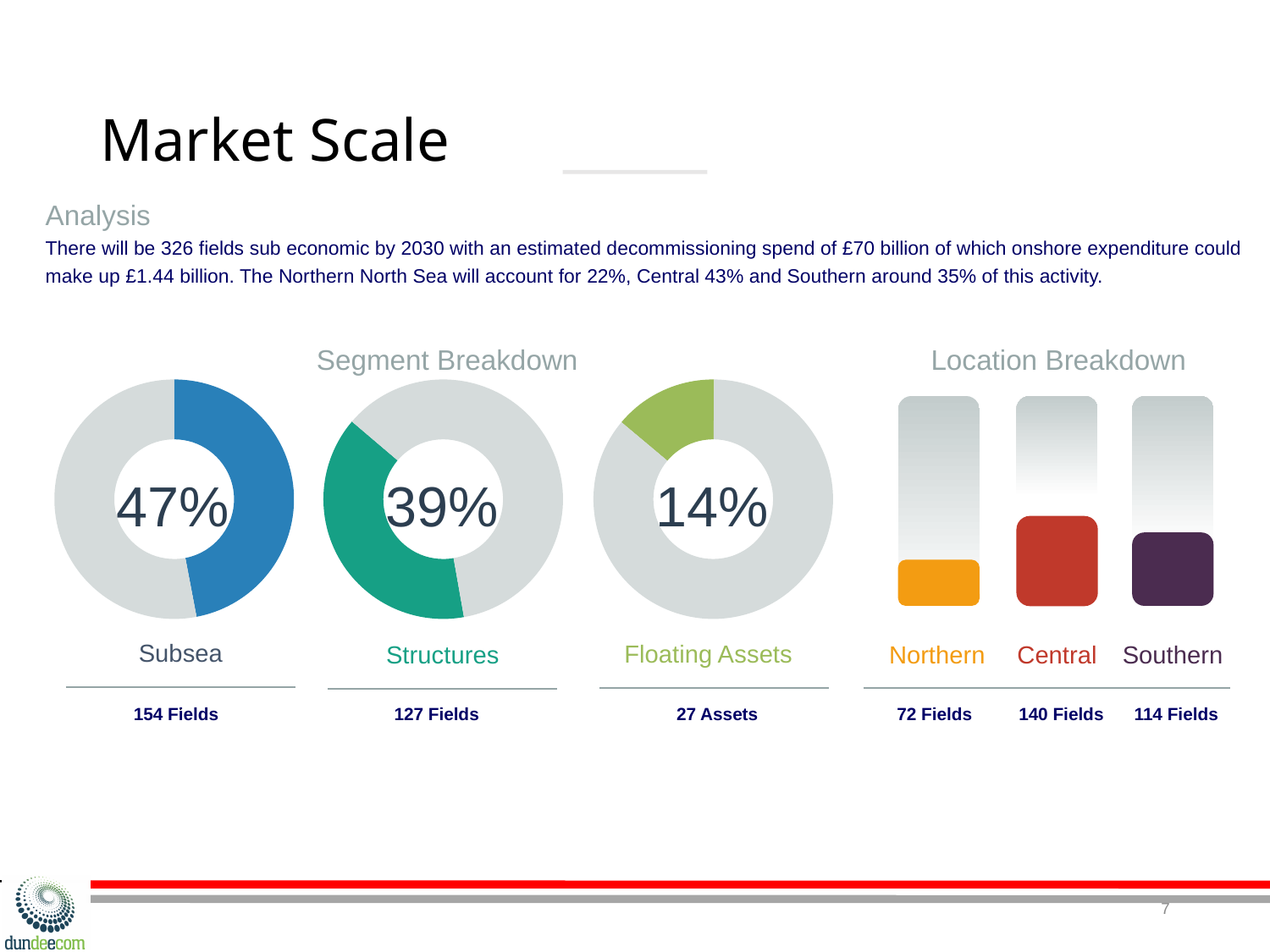
In the Segment Breakdown, which segment has the lowest percentage? Floating Assets In the Segment Breakdown, what percentage is shown for Structures? 39% What type of chart is used for the Segment Breakdown? Donut chart In the Segment Breakdown, which segment has the highest percentage? Subsea In the Location Breakdown, which location has the fewest fields? Northern In the Segment Breakdown, how many fields are listed under Subsea? 154 Fields In the Location Breakdown, how many fields are shown for Central? 140 Fields In the Location Breakdown, what is the difference in fields between Central and Northern? 68 In the Segment Breakdown, what is the difference in percentage points between Subsea and Structures? 8 In the Location Breakdown, which has more fields, Central or Southern? Central In the Segment Breakdown, what percentage is shown for Floating Assets? 14% In the Segment Breakdown, what percentage is shown for Subsea? 47%